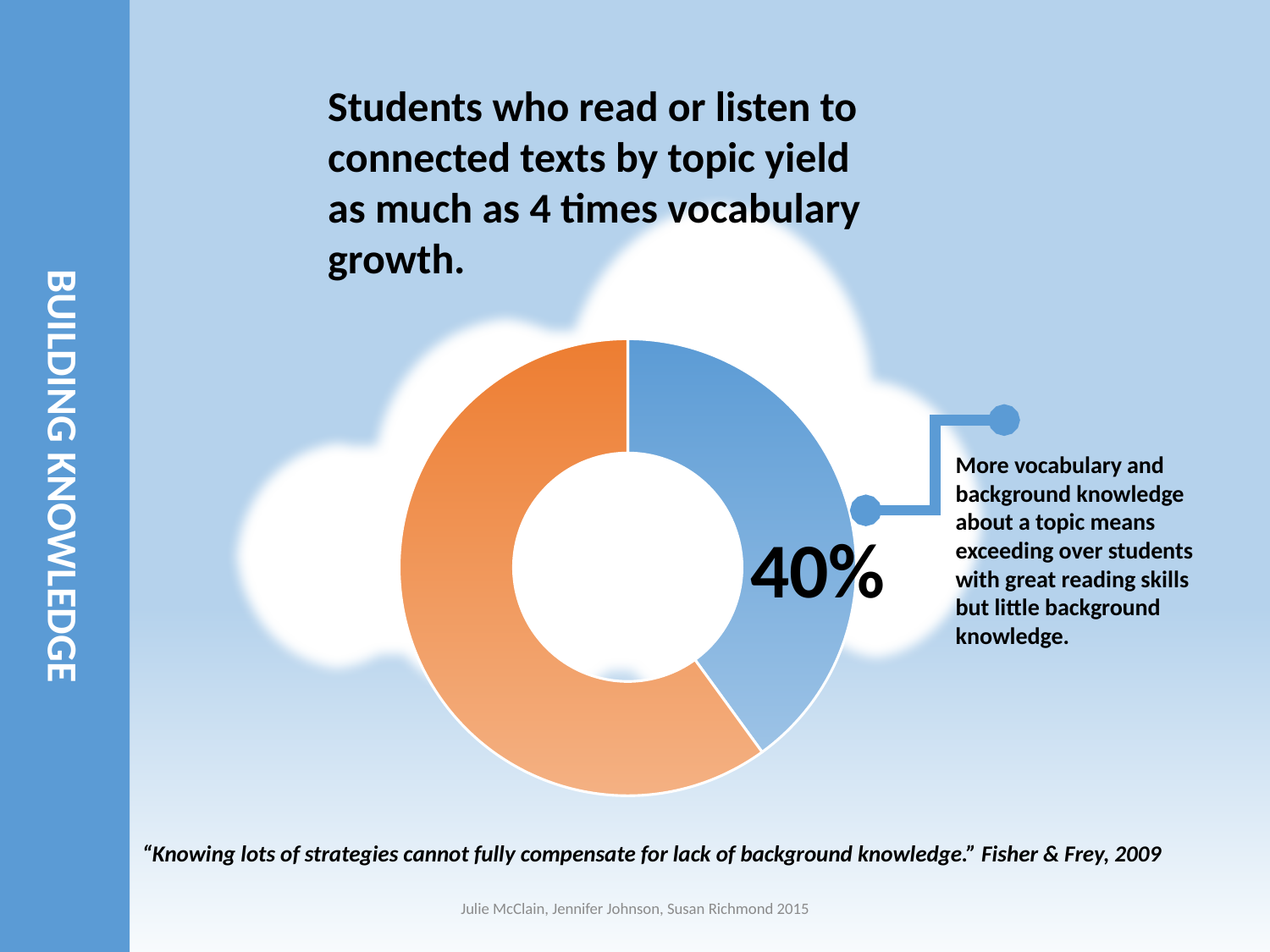
What is the only data label printed on the doughnut chart? 40% What value is labelled on the blue slice of the doughnut chart? 40% Which slice of the doughnut chart is larger, the blue one or the orange one? orange What kind of chart is shown on the slide? Doughnut (pie) chart What two colours are used for the slices of the doughnut chart? blue and orange How many slices does the doughnut chart have? 2 Which slice of the doughnut chart is the largest? orange Is the blue slice of the doughnut chart greater or less than 50%? less Which slice of the doughnut chart is the smallest? blue What share of the doughnut does the blue slice represent? 40%